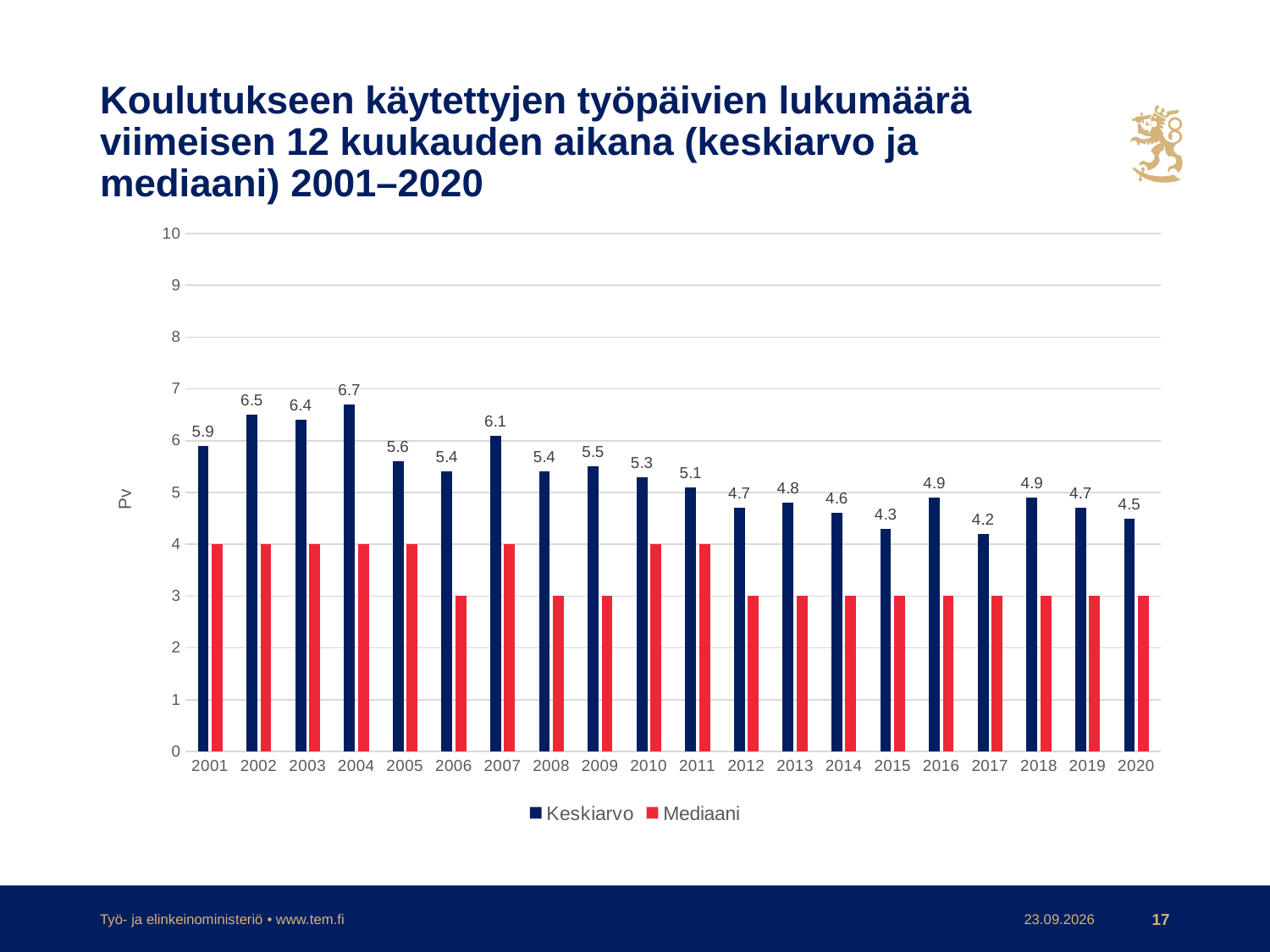
Is the Mediaani value for 2001 greater or less than 3? greater How many series does the legend list? 2 Which year has the highest Keskiarvo value? 2004 How many years are shown on the x axis? 20 What kind of chart is shown on the slide? bar chart What is the Keskiarvo value for 2011? 5.1 What is the difference between the Keskiarvo values for 2004 and 2017? 2.5 Do the Keskiarvo values generally rise or fall from 2004 to 2020? fall What is the Keskiarvo value for 2004? 6.7 What is the Keskiarvo value for 2020? 4.5 Which year has the lowest Keskiarvo value? 2017 Which is larger, the Keskiarvo value for 2007 or for 2008? 2007